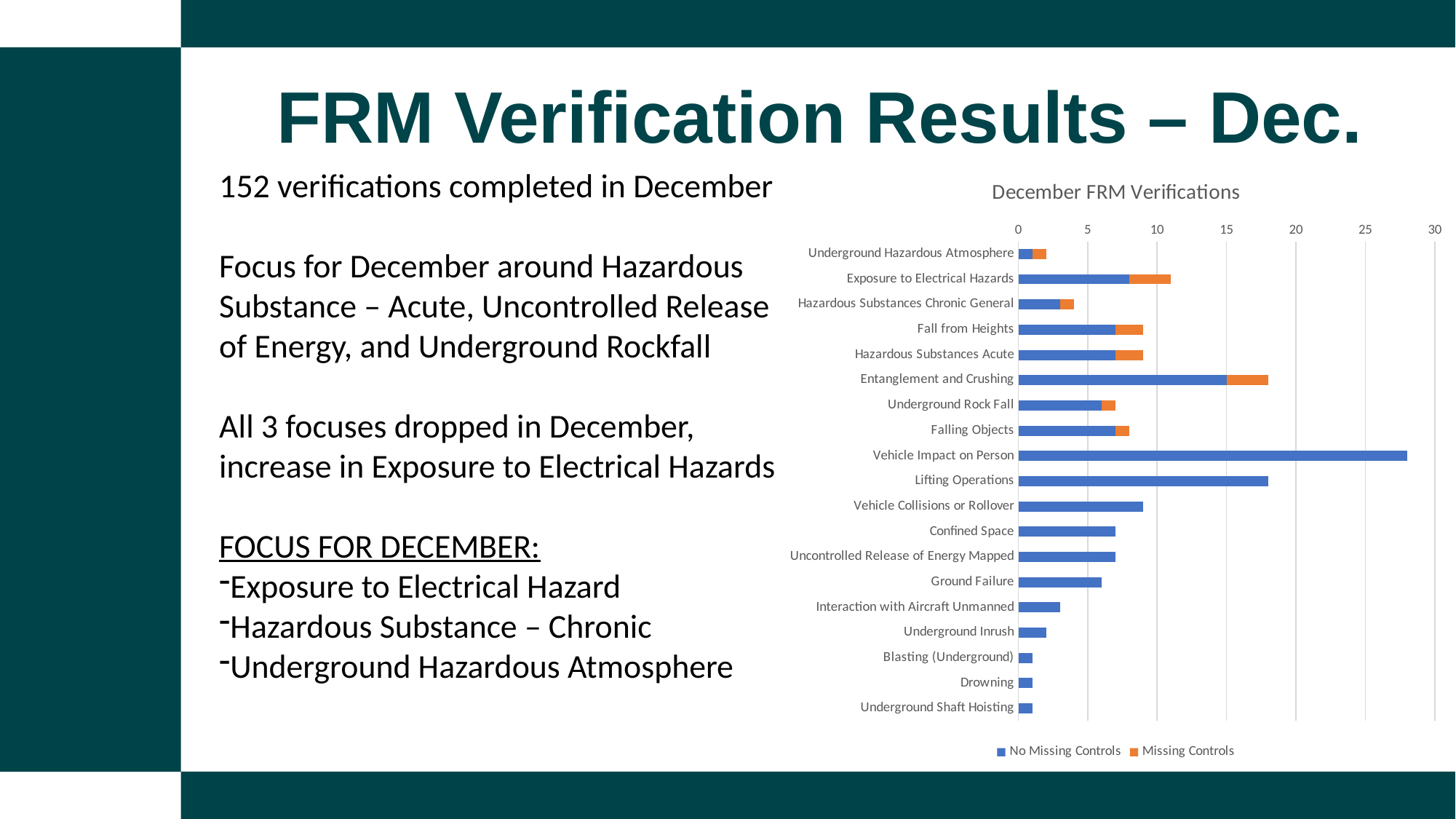
What kind of chart is shown on the slide? Bar chart Is the value for Vehicle Impact on Person greater or less than 25? greater Which has the larger total, Entanglement and Crushing or Fall from Heights? Entanglement and Crushing Is the value for Vehicle Collisions or Rollover greater or less than 10? less Which category has the highest total in the chart? Vehicle Impact on Person How many series does the chart legend list? 2 Is the value for Underground Hazardous Atmosphere greater or less than 5? less How many categories are plotted in the chart? 19 Which has the larger total, Lifting Operations or Vehicle Collisions or Rollover? Lifting Operations Which series is shown in orange in the chart? Missing Controls What is the title of the chart? December FRM Verifications